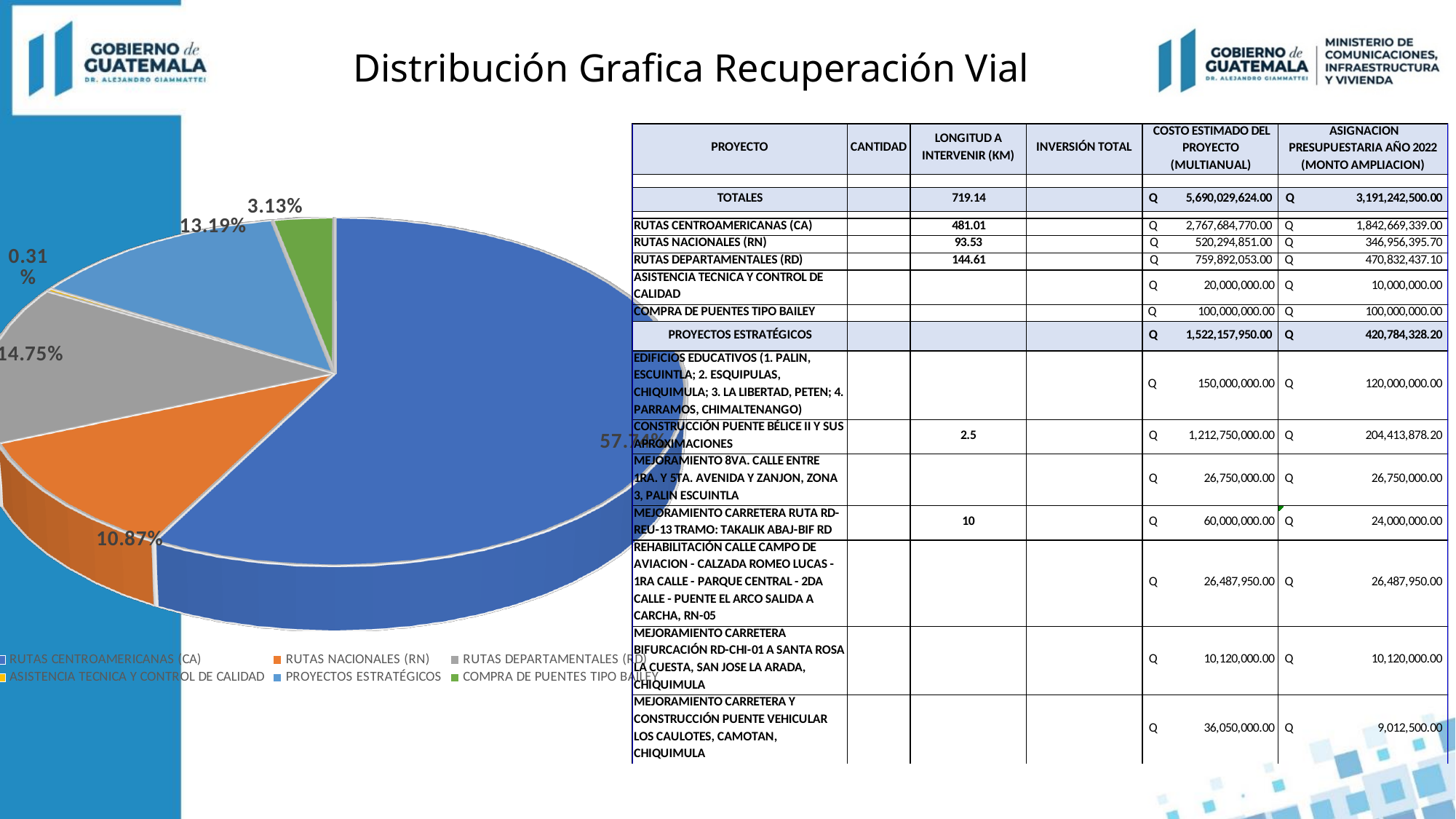
What type of chart is shown on the slide? Pie chart What percentage share does RUTAS NACIONALES (RN) have in the pie chart? 10.87% Which category has the largest slice in the pie chart? RUTAS CENTROAMERICANAS (CA) What percentage share does ASISTENCIA TECNICA Y CONTROL DE CALIDAD have in the pie chart? 0.31% Which category has the smallest slice in the pie chart? ASISTENCIA TECNICA Y CONTROL DE CALIDAD Which has a larger share, RUTAS DEPARTAMENTALES (RD) or PROYECTOS ESTRATÉGICOS? RUTAS DEPARTAMENTALES (RD) What colour is the slice for COMPRA DE PUENTES TIPO BAILEY? Green What percentage share does PROYECTOS ESTRATÉGICOS have in the pie chart? 13.19% What percentage share does COMPRA DE PUENTES TIPO BAILEY have in the pie chart? 3.13% What is the difference in percentage points between RUTAS DEPARTAMENTALES (RD) and RUTAS NACIONALES (RN)? 3.88 How many categories are shown in the pie chart legend? 6 What percentage share does RUTAS DEPARTAMENTALES (RD) have in the pie chart? 14.75%